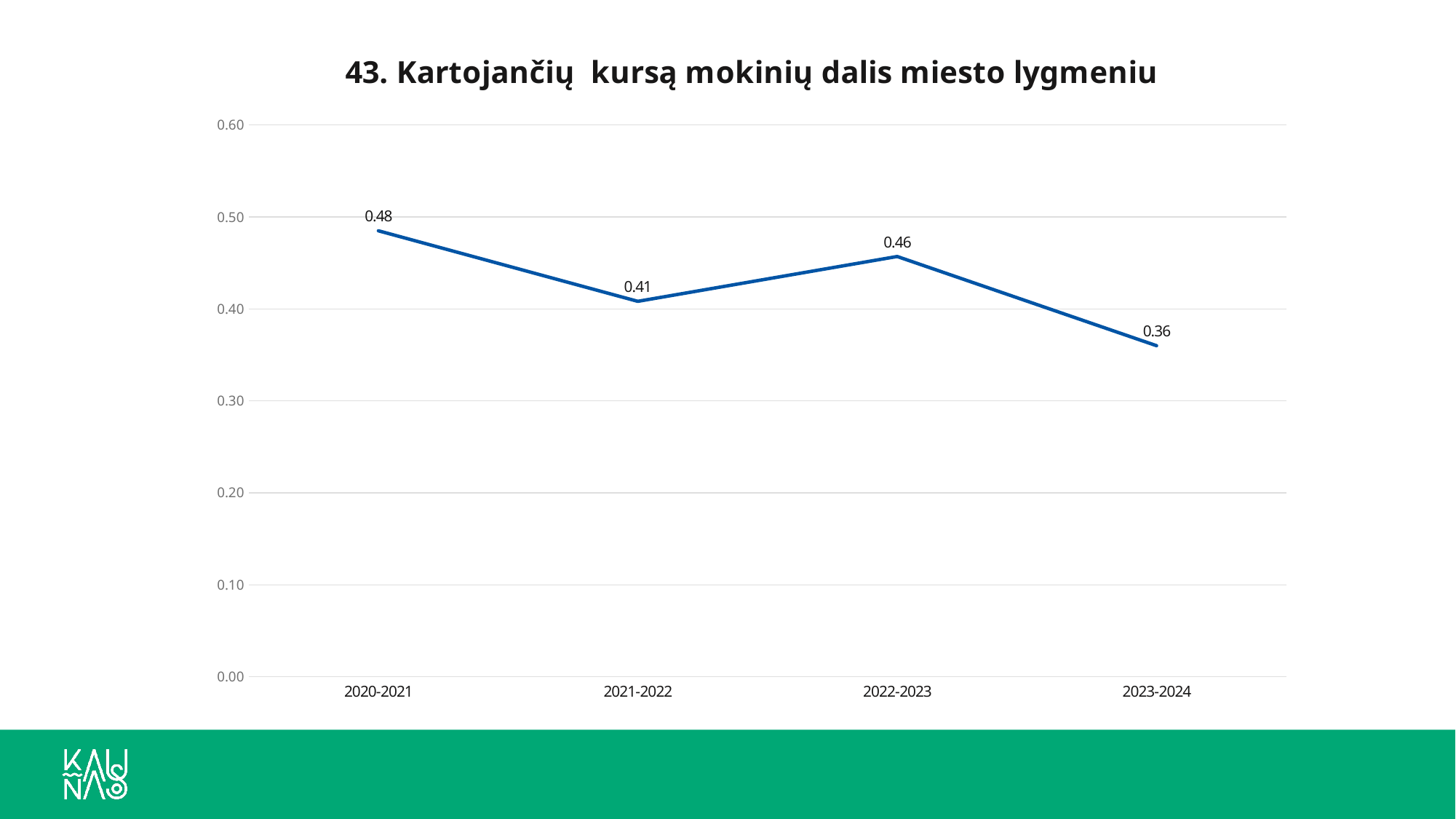
Is the value for 2023-2024 greater or less than 0.40? less What is the value for 2020-2021? 0.48 What is the value for 2022-2023? 0.46 What kind of chart is shown on the slide? line chart What is the title of the chart? 43. Kartojančių kursą mokinių dalis miesto lygmeniu Which is larger, the value for 2021-2022 or the value for 2022-2023? 2022-2023 What is the difference between the values for 2020-2021 and 2023-2024? 0.12 What is the value for 2023-2024? 0.36 Which school year has the highest value? 2020-2021 What is the value for 2021-2022? 0.41 How many school years are plotted on the chart? 4 Which school year has the lowest value? 2023-2024